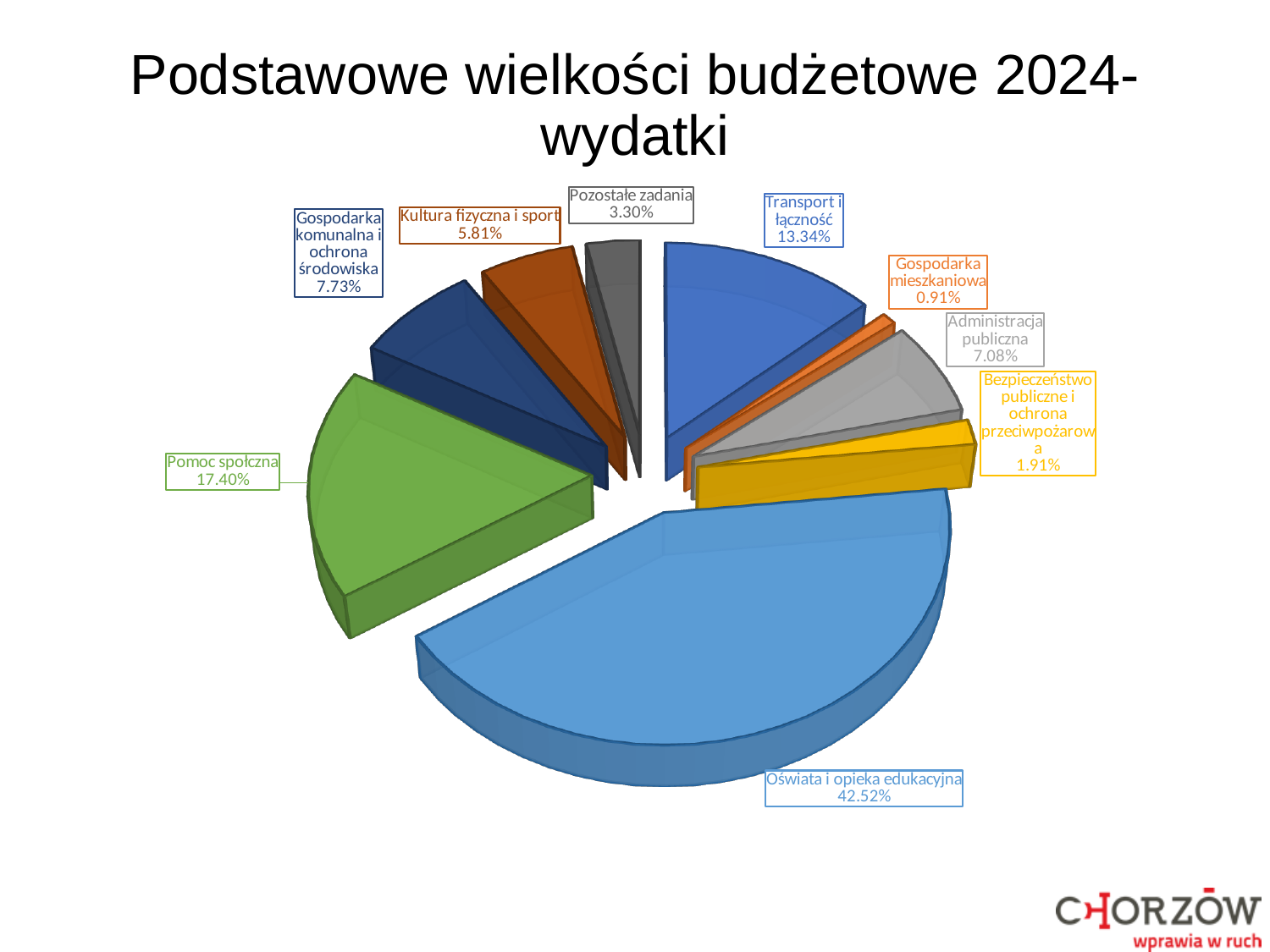
What is the value shown for Administracja publiczna? 7.08% How many slices does the pie chart have? 9 What share of the pie does Oświata i opieka edukacyjna have? 42.52% What is the title of the chart slide? Podstawowe wielkości budżetowe 2024- wydatki Which is larger, Kultura fizyczna i sport or Pozostałe zadania? Kultura fizyczna i sport What is the difference between the shares of Pomoc społczna and Transport i łączność? 4.06% Which category has the largest slice of the pie? Oświata i opieka edukacyjna What is the value shown for Pomoc społczna? 17.40% What kind of chart is shown on the slide? pie chart What is the value shown for Gospodarka komunalna i ochrona środowiska? 7.73% Which category has the smallest slice of the pie? Gospodarka mieszkaniowa What is the value shown for Transport i łączność? 13.34%